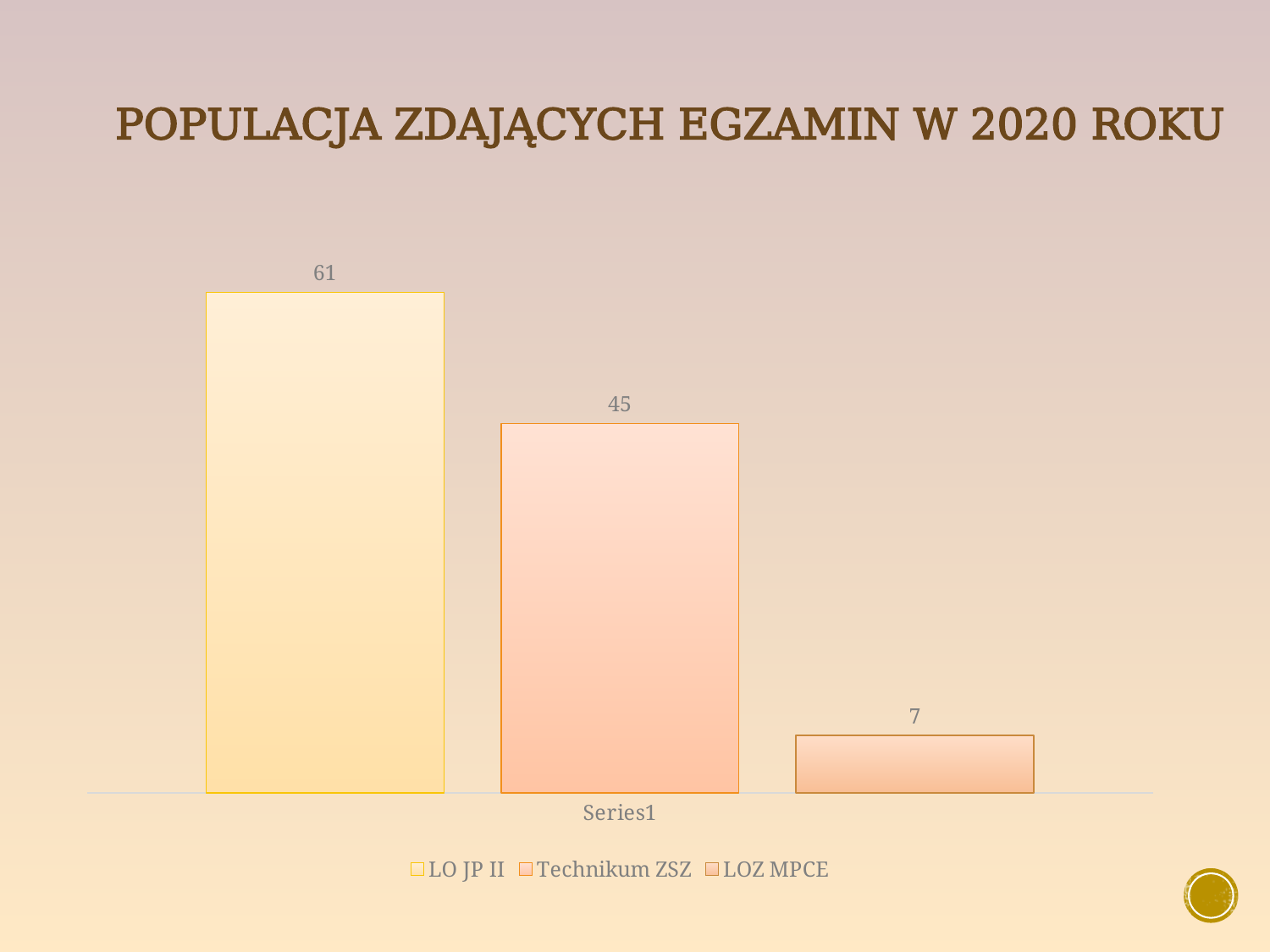
What is the value for LO JP II? 61 What is the value for Technikum ZSZ? 45 What kind of chart is shown on the slide? Bar chart What is the title of the slide? POPULACJA ZDAJĄCYCH EGZAMIN W 2020 ROKU What is the difference between the values for Technikum ZSZ and LOZ MPCE? 38 How many bars are shown in the chart? 3 What is the difference between the values for LO JP II and Technikum ZSZ? 16 What is the value for LOZ MPCE? 7 Which school has the lowest value? LOZ MPCE Which is larger, the value for Technikum ZSZ or the value for LOZ MPCE? Technikum ZSZ How many entries does the legend list? 3 Which school has the highest value? LO JP II